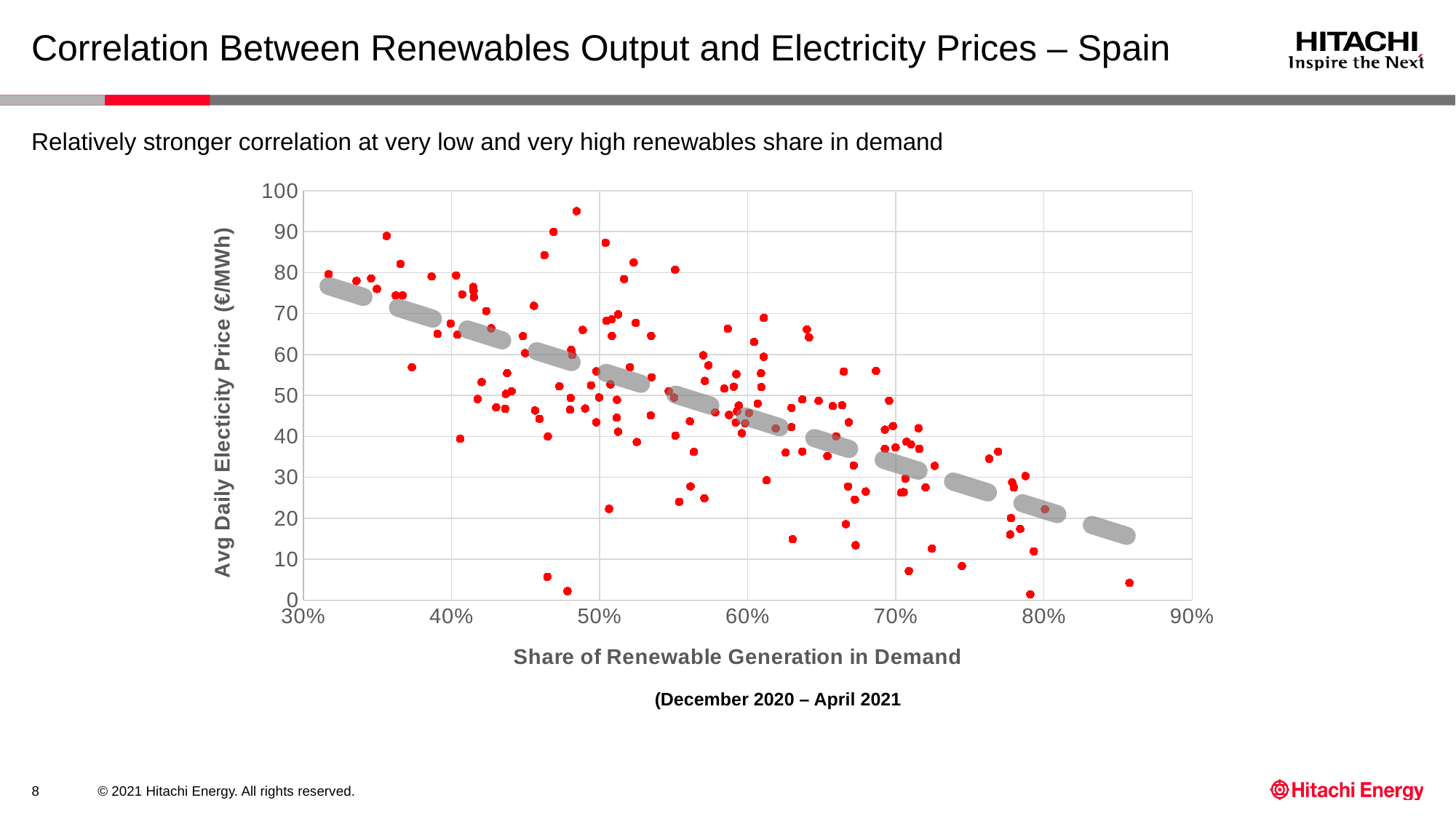
What is the label of the y axis? Avg Daily Electricity Price (€/MWh) Do electricity prices generally rise or fall as the share of renewable generation in demand increases? fall Is the highest plotted electricity price greater or less than 90? greater Is the trend line value at a 60% renewables share greater or less than 40? greater What is the label of the x axis? Share of Renewable Generation in Demand What kind of chart is shown on the slide? scatter chart Is the trend line value at an 80% renewables share greater or less than 30? less What is the maximum value shown on the y axis? 100